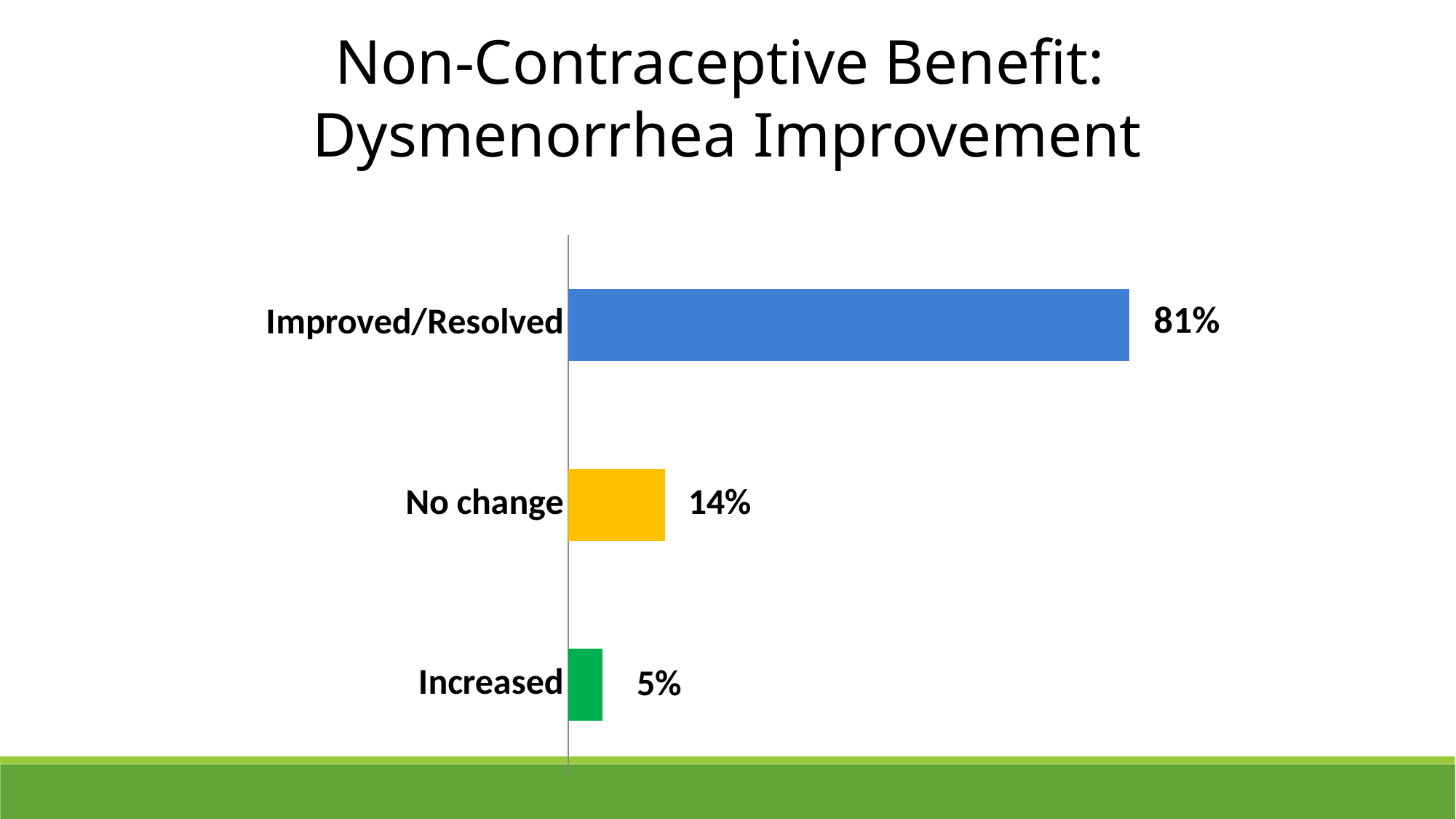
How many categories are shown in the chart? 3 Which is larger, the value for No change or the value for Increased? No change What is the title of the slide? Non-Contraceptive Benefit: Dysmenorrhea Improvement Which category has the lowest value? Increased What is the value for Increased? 5% What colour is the bar for No change? yellow What is the difference between the values for Improved/Resolved and No change? 67% What is the value for No change? 14% What is the difference between the values for No change and Increased? 9% Which category has the highest value? Improved/Resolved What is the value for Improved/Resolved? 81% What kind of chart is shown on the slide? bar chart